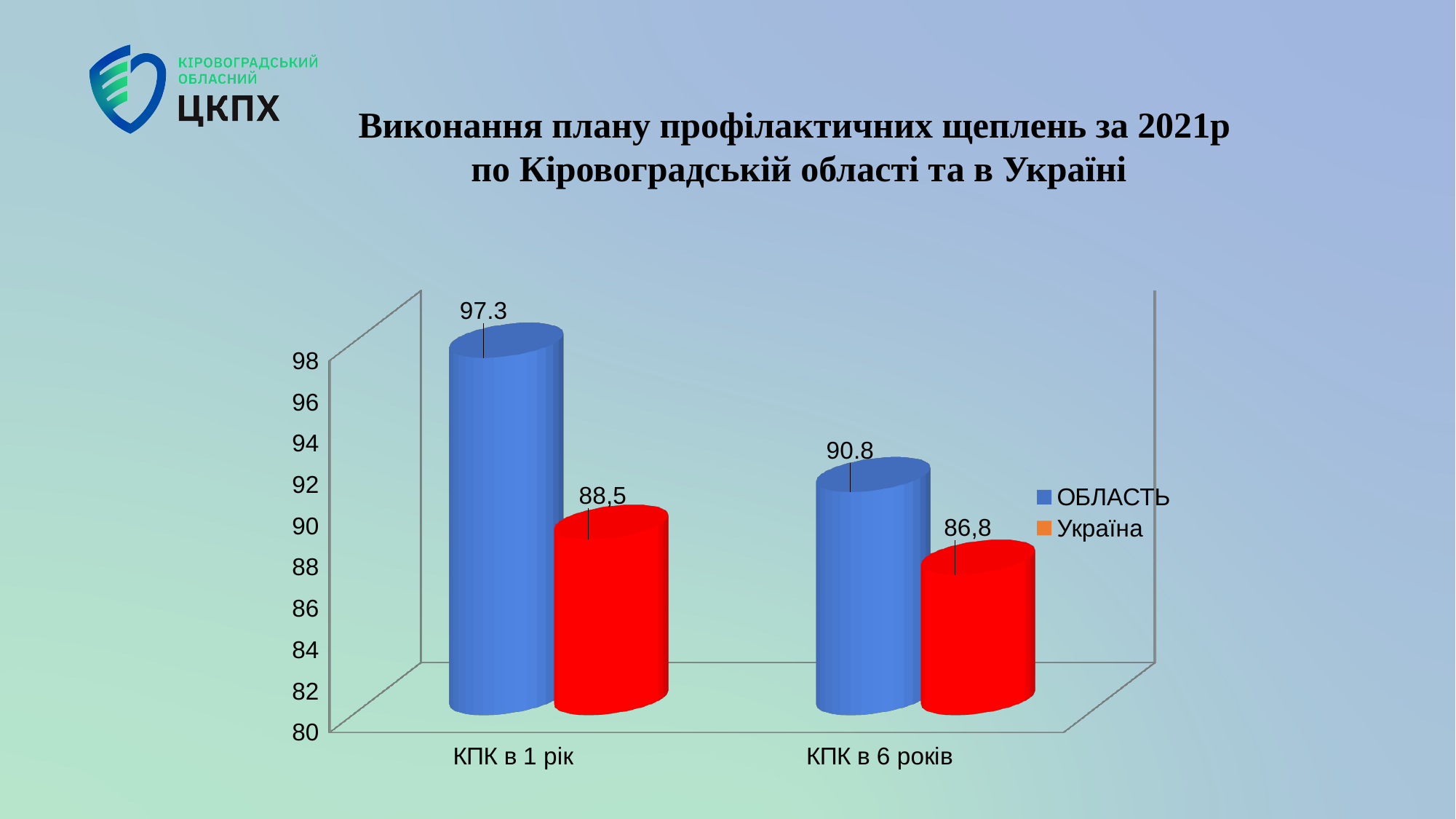
What kind of chart is shown on the slide? Bar chart What is the difference between the Україна values for КПК в 1 рік and КПК в 6 років? 1,7 Which bar has the lowest value on the chart? Україна, КПК в 6 років What is the value for Україна in the category КПК в 1 рік? 88,5 What is the value for ОБЛАСТЬ in the category КПК в 6 років? 90.8 How many series does the legend list? 2 Which bar has the highest value on the chart? ОБЛАСТЬ, КПК в 1 рік What is the value for Україна in the category КПК в 6 років? 86,8 In the category КПК в 6 років, which series has the larger value, ОБЛАСТЬ or Україна? ОБЛАСТЬ What is the value for ОБЛАСТЬ in the category КПК в 1 рік? 97.3 How many categories are shown on the x axis? 2 What is the difference between the ОБЛАСТЬ values for КПК в 1 рік and КПК в 6 років? 6.5